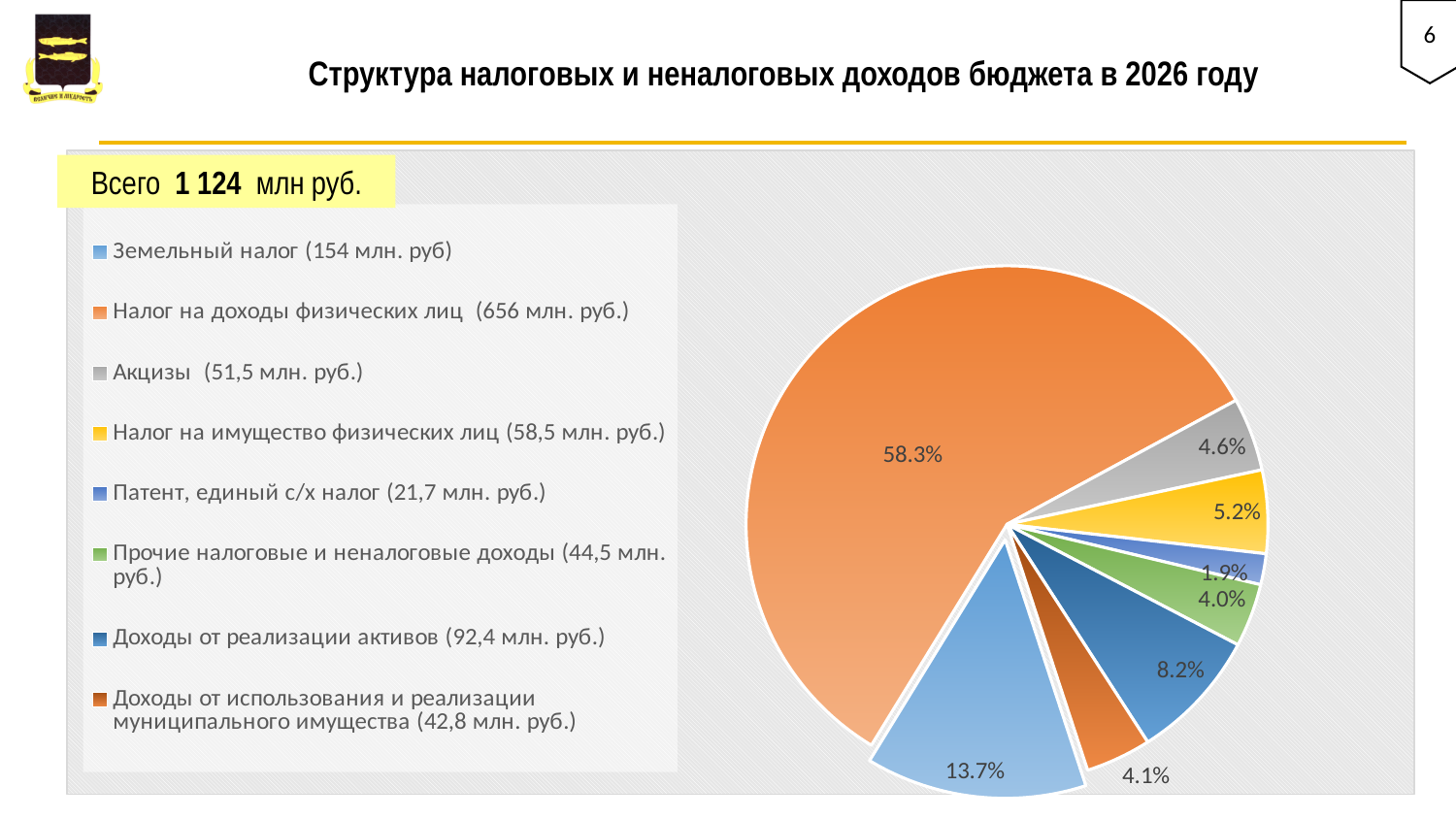
What value in млн. руб. does the legend give for "Акцизы"? 51,5 млн. руб. How many slices does the pie chart have? 8 Which category has the largest slice of the pie? Налог на доходы физических лиц What total amount is stated above the legend on the slide? 1 124 млн руб. Which is larger: the share for "Налог на имущество физических лиц" or the share for "Акцизы"? Налог на имущество физических лиц What share of the pie does "Земельный налог" have? 13.7% What kind of chart is shown on the slide? pie chart What is the difference in percentage points between the share for "Земельный налог" and the share for "Доходы от реализации активов"? 5.5 What share of the pie does "Налог на доходы физических лиц" have? 58.3% What share of the pie does "Доходы от реализации активов" have? 8.2% Which category has the smallest slice of the pie? Патент, единый с/х налог